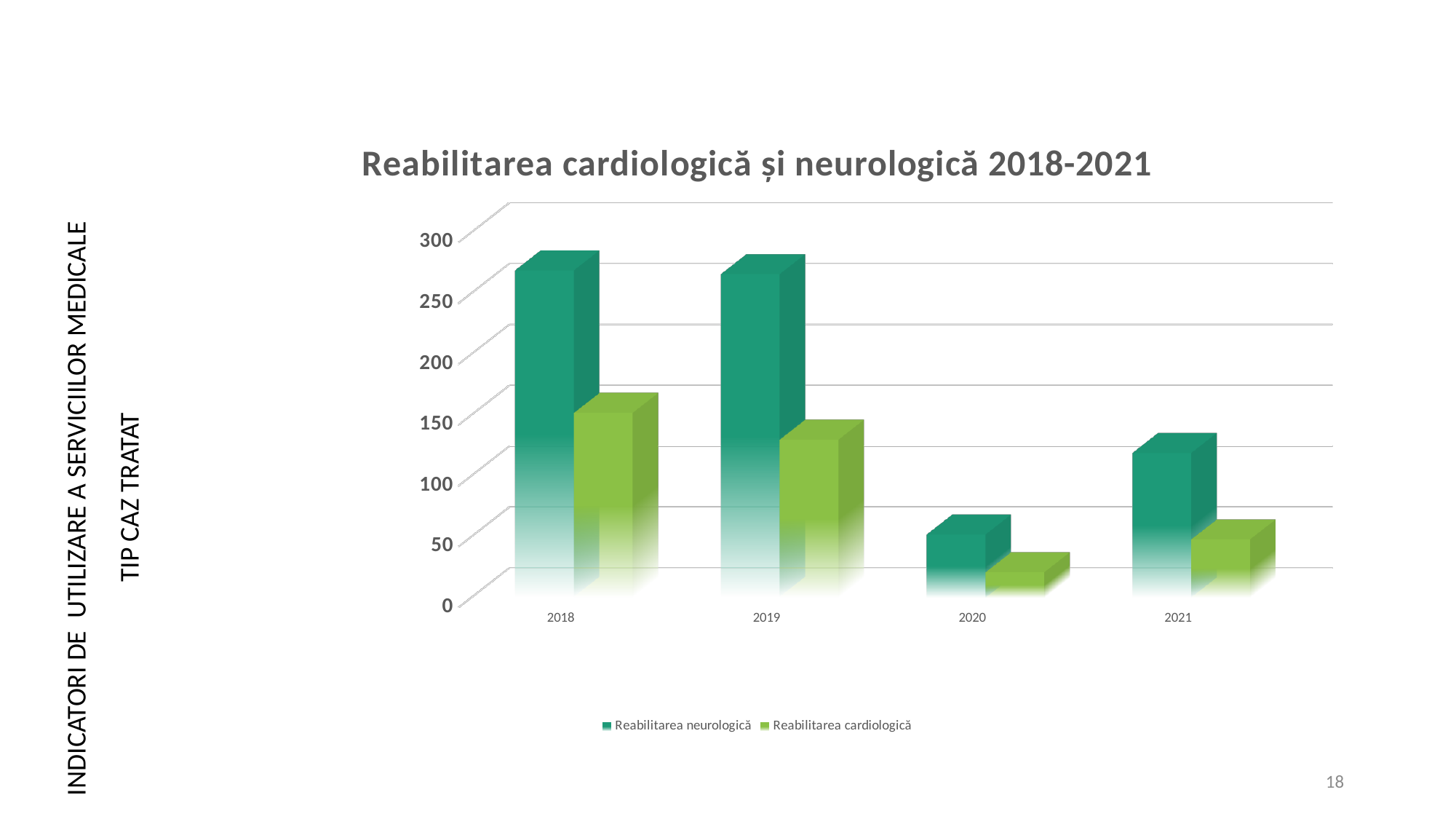
Which series is drawn in light green? Reabilitarea cardiologică How many years are shown on the x axis? 4 In which year is the value for Reabilitarea neurologică lowest? 2020 Is the value for Reabilitarea neurologică in 2021 greater or less than 100? greater Does the value for Reabilitarea cardiologică rise or fall from 2018 to 2020? fall What is the title of the chart? Reabilitarea cardiologică și neurologică 2018-2021 How many series does the legend list? 2 In which year is the value for Reabilitarea cardiologică lowest? 2020 Is the value for Reabilitarea cardiologică in 2020 greater or less than 50? less Is the value for Reabilitarea neurologică in 2018 greater or less than 250? greater In 2021, which is larger: Reabilitarea neurologică or Reabilitarea cardiologică? Reabilitarea neurologică What kind of chart is shown on the slide? bar chart